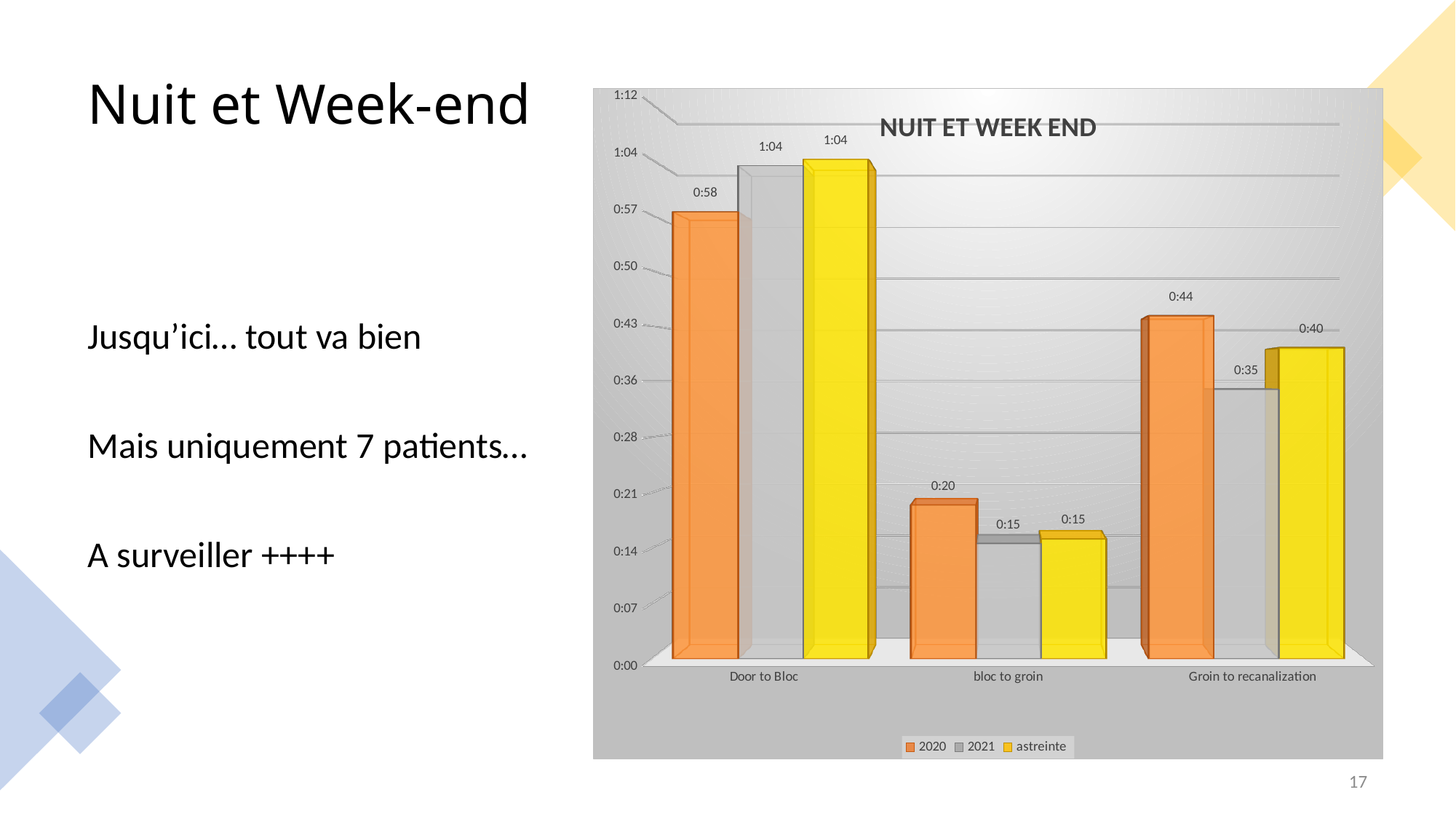
What kind of chart is shown on the slide? Bar chart What is the value for 2021 in the Groin to recanalization category? 0:35 What is the difference between the 2020 and 2021 values in the Groin to recanalization category? 0:09 How many series does the legend list? 3 Which category has the highest value for the 2020 series? Door to Bloc What is the value for 2020 in the Door to Bloc category? 0:58 In the Door to Bloc category, which is larger: the 2020 value or the 2021 value? 2021 What is the value for astreinte in the Groin to recanalization category? 0:40 What is the title of the chart? NUIT ET WEEK END Which category has the lowest value for the 2021 series? bloc to groin What is the value for astreinte in the bloc to groin category? 0:15 How many categories are shown on the x axis? 3